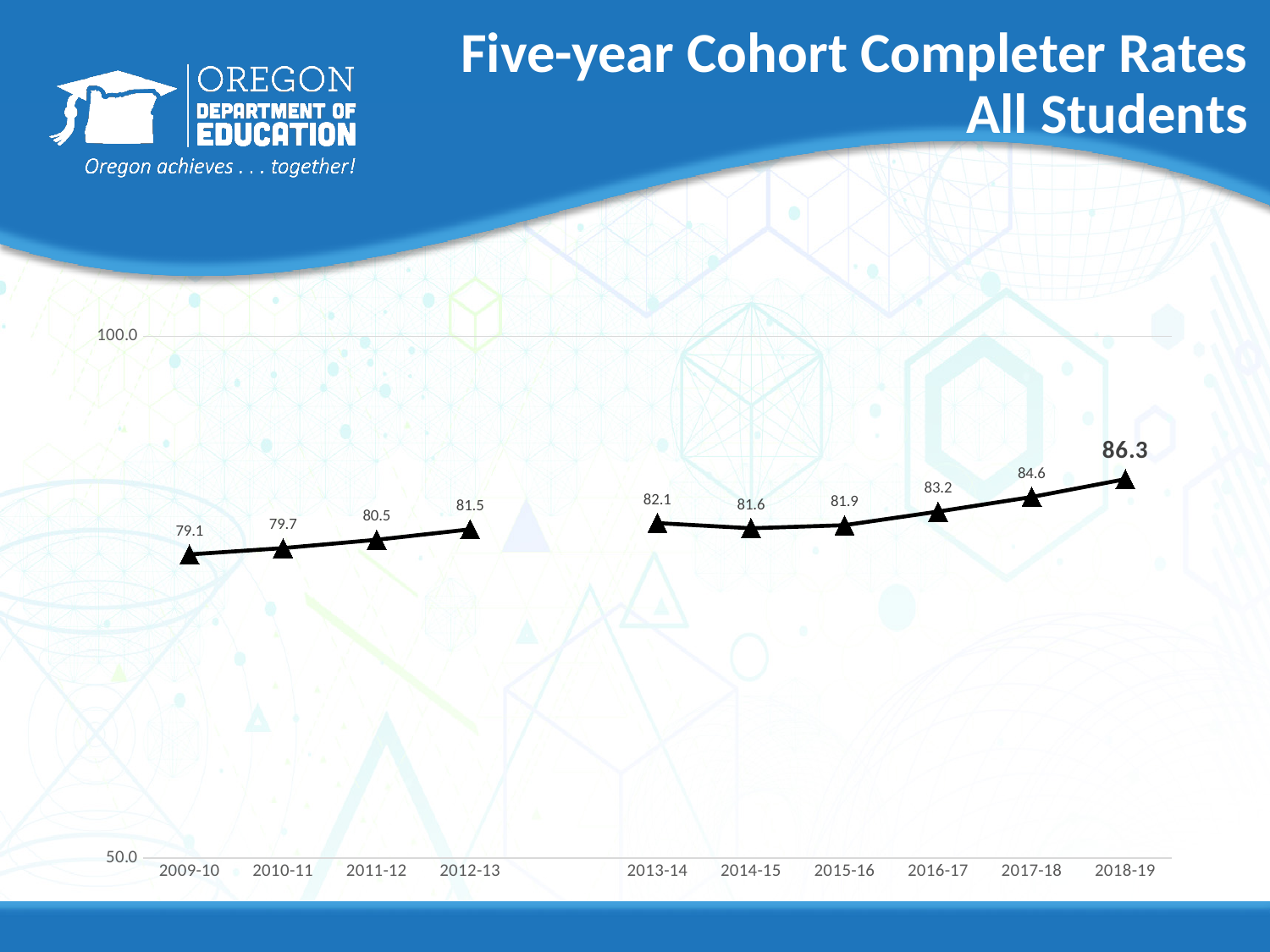
Which year has the highest completer rate? 2018-19 Which is larger, the rate for 2013-14 or the rate for 2014-15? 2013-14 What kind of chart is shown on the slide? line chart What is the value plotted for 2016-17? 83.2 Which year has the lowest completer rate? 2009-10 Is the value for 2017-18 greater or less than 100.0? less What is the five-year cohort completer rate for 2018-19? 86.3 Do the completer rates generally rise or fall from 2014-15 to 2018-19? rise What is the value plotted for 2013-14? 82.1 What is the five-year cohort completer rate for 2009-10? 79.1 What is the difference between the 2018-19 rate and the 2009-10 rate? 7.2 How many years are plotted on the chart? 10